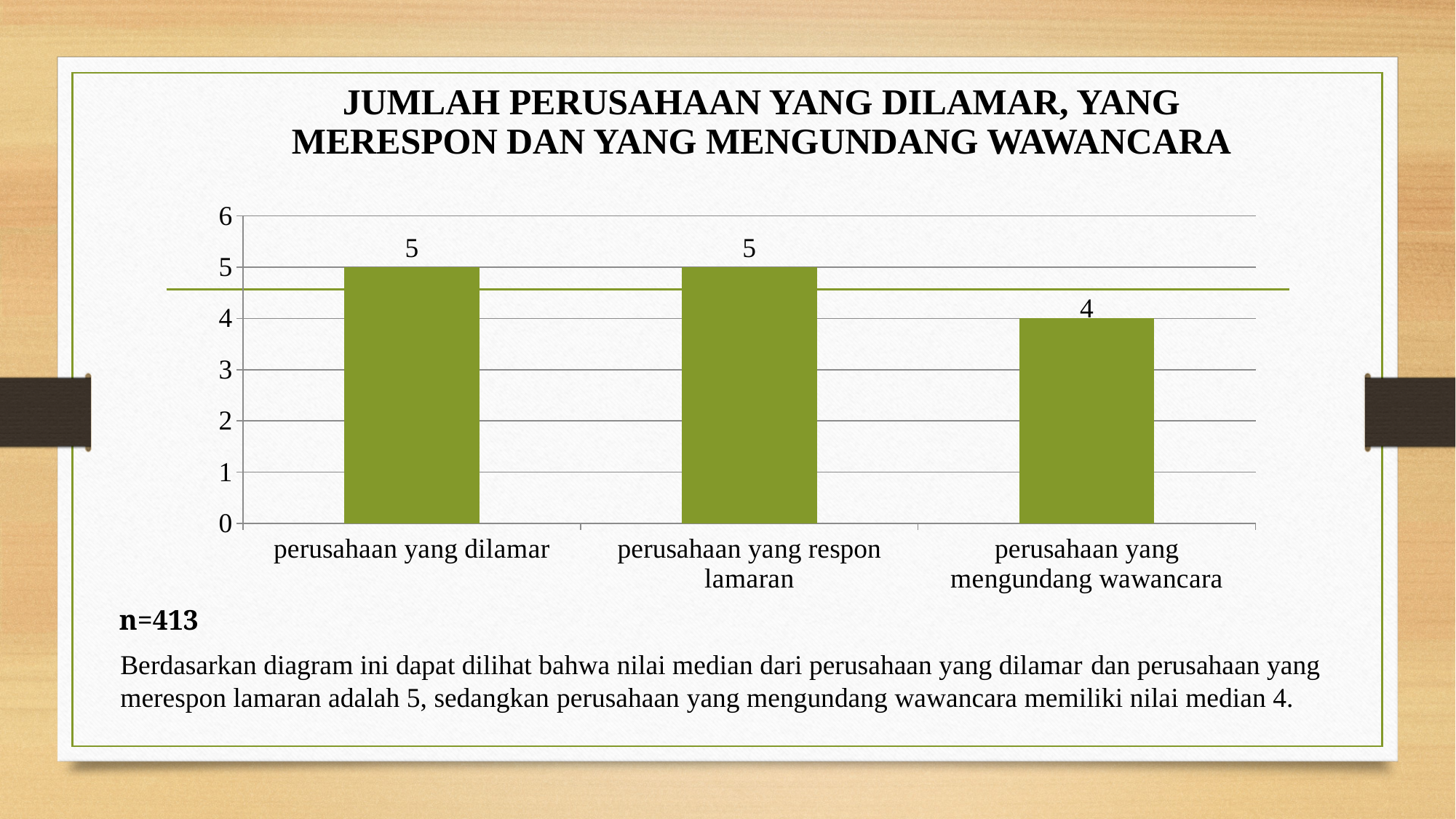
What is the highest value shown on the y axis? 6 What is the difference between the values for 'perusahaan yang dilamar' and 'perusahaan yang mengundang wawancara'? 1 What kind of chart is shown on the slide? bar chart What is the value for 'perusahaan yang mengundang wawancara'? 4 What is the value for 'perusahaan yang dilamar'? 5 Do the values rise or fall from the first category to the last? fall What is the title of the chart? JUMLAH PERUSAHAAN YANG DILAMAR, YANG MERESPON DAN YANG MENGUNDANG WAWANCARA Which category has the lowest value? perusahaan yang mengundang wawancara Which is larger: the value for 'perusahaan yang respon lamaran' or 'perusahaan yang mengundang wawancara'? perusahaan yang respon lamaran What is the value for 'perusahaan yang respon lamaran'? 5 How many categories are shown on the x axis? 3 Is the value for 'perusahaan yang mengundang wawancara' greater or less than 5? less